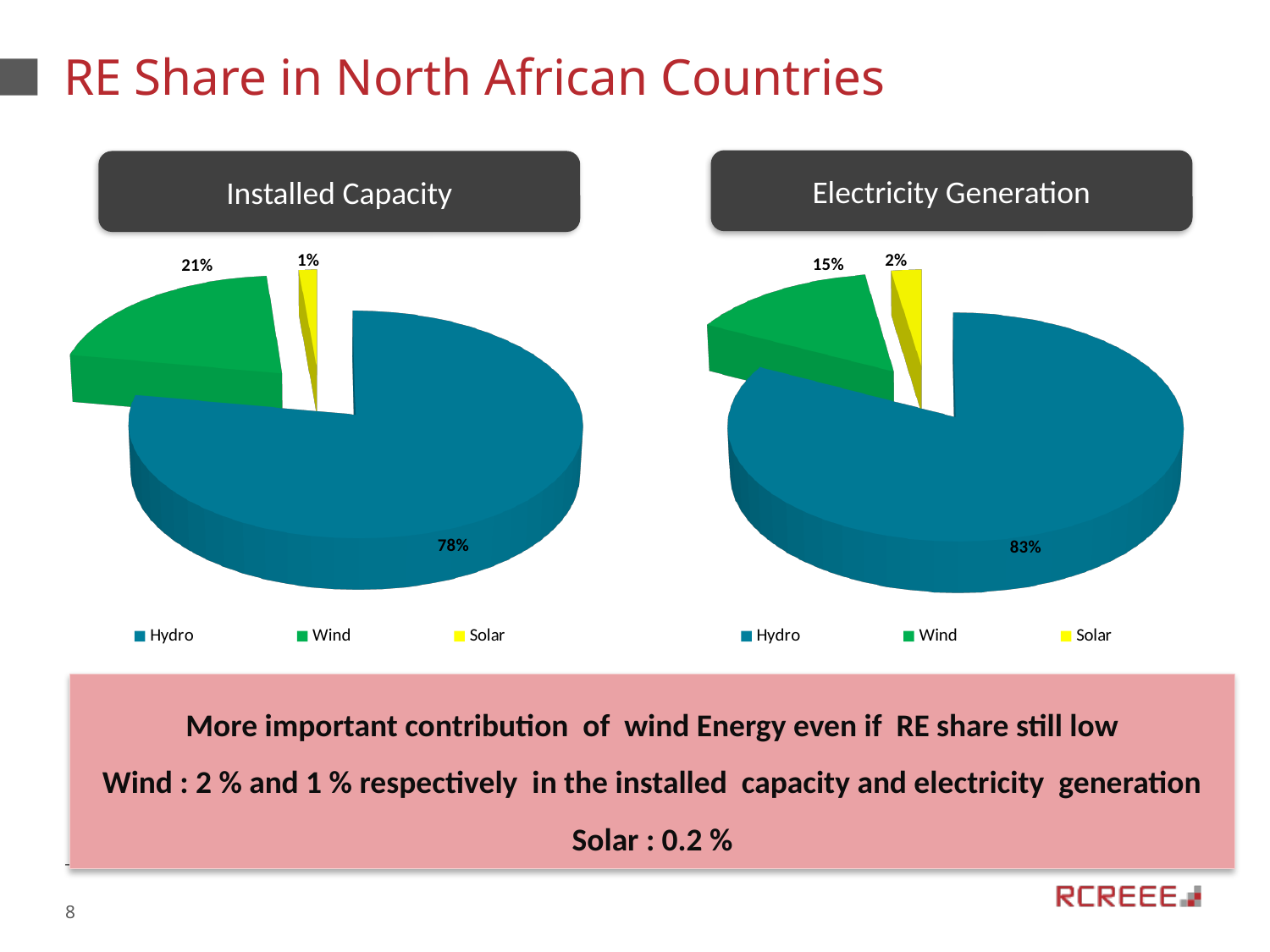
In the Installed Capacity chart, which source has the largest share? Hydro In the Electricity Generation chart, what is the difference between the Wind and Solar shares? 13% In the Installed Capacity chart, what share does Wind have? 21% How many categories does the Electricity Generation chart show? 3 In the Electricity Generation chart, which source has the smallest share? Solar Is the Wind share larger in the Installed Capacity chart or the Electricity Generation chart? Installed Capacity In the Installed Capacity chart, what is the difference between the Hydro and Wind shares? 57% In the Electricity Generation chart, what share does Hydro have? 83% In the Electricity Generation chart, what share does Solar have? 2% What kind of chart is the Installed Capacity chart? Pie chart In the Installed Capacity chart, what share does Hydro have? 78% In the Installed Capacity chart, which colour represents Solar? Yellow